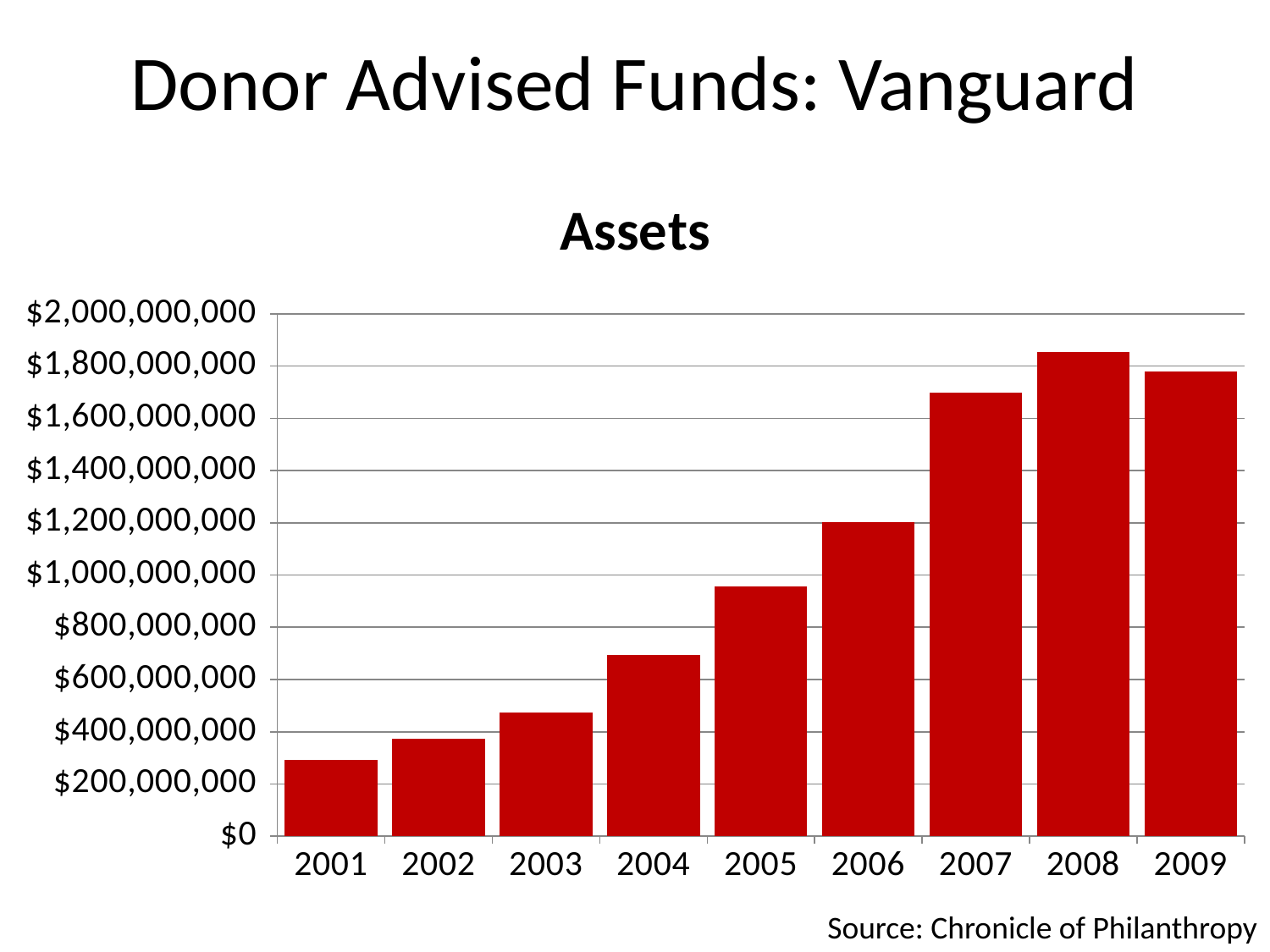
Do the values generally rise or fall from 2001 to 2008? rise Which is larger, the value for 2002 or the value for 2003? 2003 Which is larger, the value for 2006 or the value for 2007? 2007 What kind of chart is shown on the slide? bar chart How many years are shown on the x axis of the chart? 9 Is the value for 2001 greater or less than $400,000,000? less Which year has the lowest assets value? 2001 Which year has the highest assets value? 2008 Is the value for 2006 greater or less than $1,000,000,000? greater Is the value for 2007 greater or less than $1,600,000,000? greater What is the title of the chart? Assets